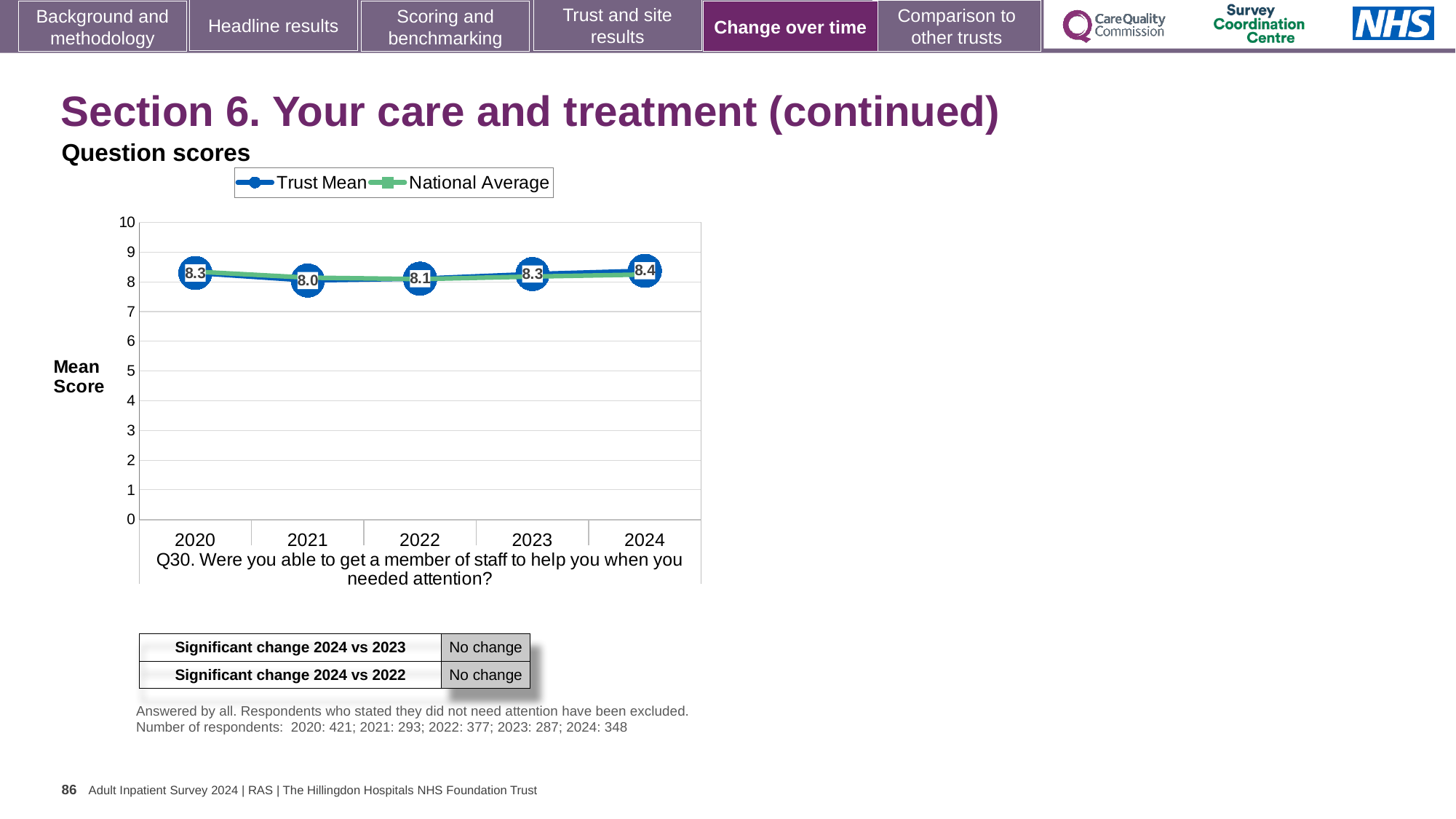
What is the Trust Mean score for 2021? 8.0 What kind of chart is shown on the slide? line chart How many years are plotted on the x axis? 5 Is the National Average value for 2024 greater or less than 7? greater What is the Trust Mean score for 2024? 8.4 Does the Trust Mean score rise or fall from 2021 to 2024? rise In which year is the Trust Mean score highest? 2024 Which is larger, the Trust Mean score for 2020 or for 2021? 2020 How many series does the legend list? 2 In which year is the Trust Mean score lowest? 2021 What is the difference between the Trust Mean scores for 2024 and 2021? 0.4 What is the Trust Mean score for 2022? 8.1